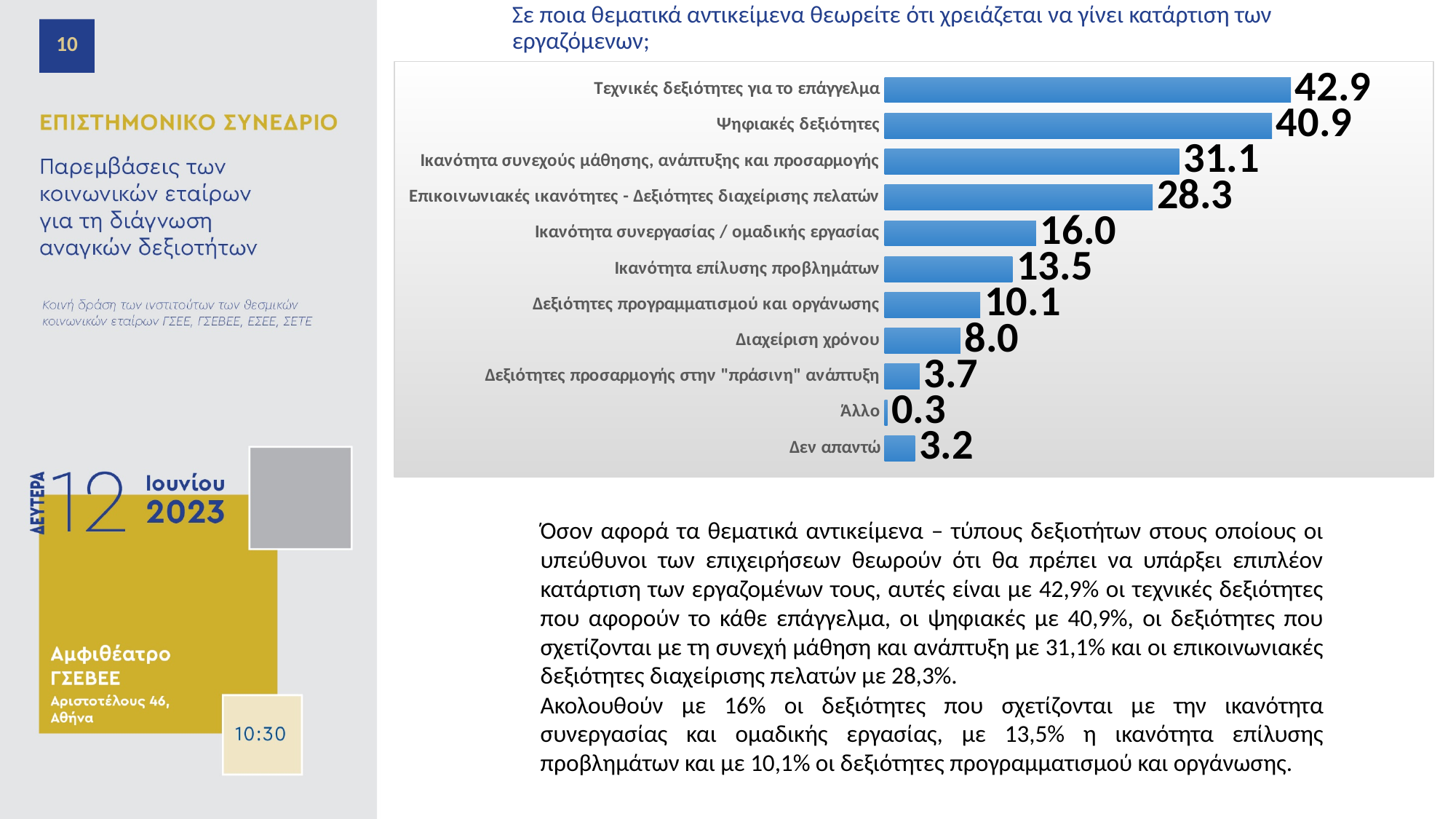
Which category has the highest value? Τεχνικές δεξιότητες για το επάγγελμα What type of chart is shown on the slide? Bar chart What is the value for Ψηφιακές δεξιότητες? 40.9 How many categories are shown in the chart? 11 What is the value for Ικανότητα επίλυσης προβλημάτων? 13.5 What is the difference between the values for Ικανότητα συνεργασίας / ομαδικής εργασίας and Ικανότητα επίλυσης προβλημάτων? 2.5 Which is larger: the value for Δεν απαντώ or the value for Δεξιότητες προσαρμογής στην "πράσινη" ανάπτυξη? Δεξιότητες προσαρμογής στην "πράσινη" ανάπτυξη What is the value for Διαχείριση χρόνου? 8.0 What is the value for Δεξιότητες προσαρμογής στην "πράσινη" ανάπτυξη? 3.7 What is the difference between the values for Τεχνικές δεξιότητες για το επάγγελμα and Ψηφιακές δεξιότητες? 2.0 What is the title of the chart? Σε ποια θεματικά αντικείμενα θεωρείτε ότι χρειάζεται να γίνει κατάρτιση των εργαζόμενων; Which category has the lowest value? Άλλο